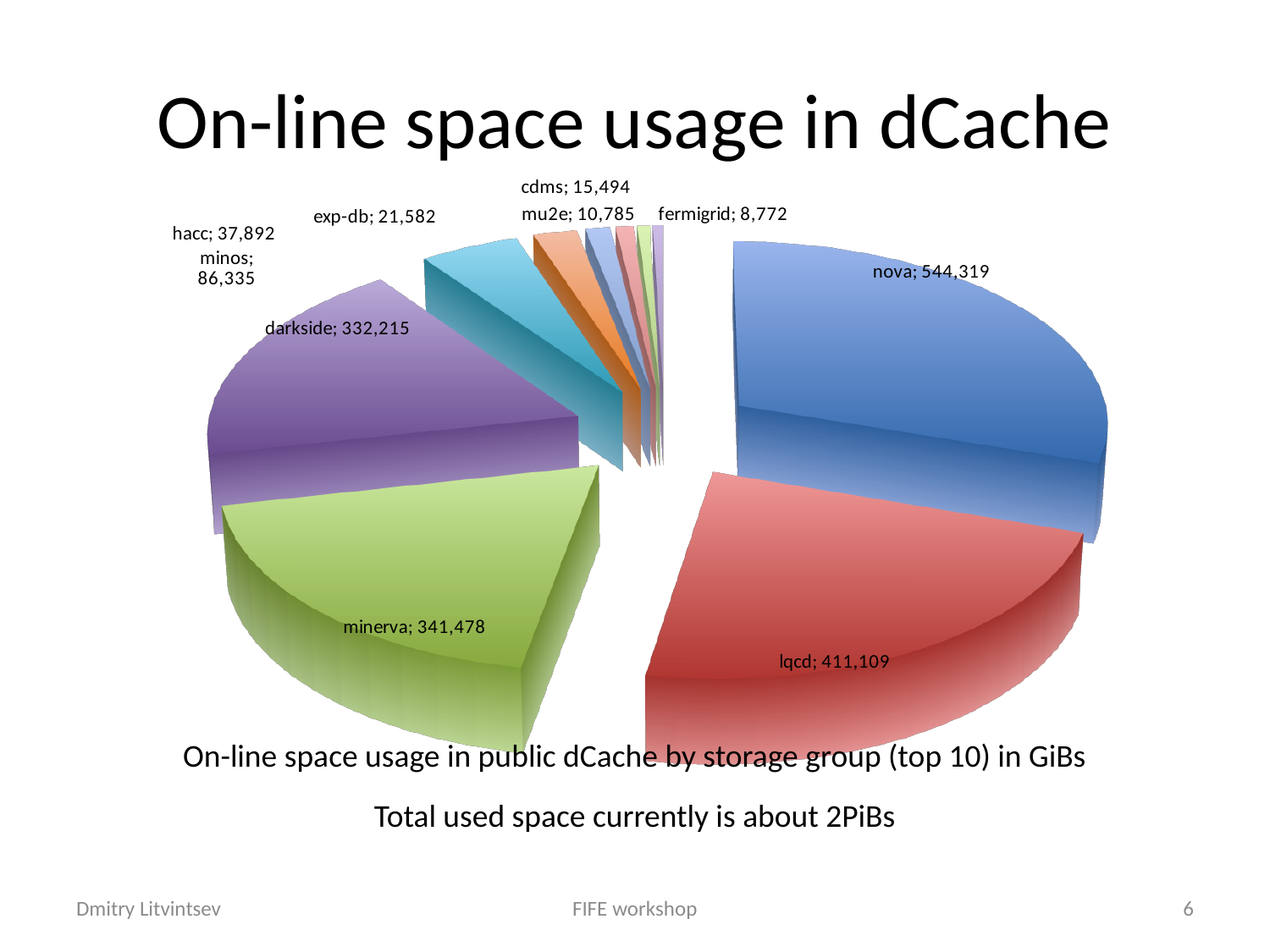
What kind of chart is shown on the slide? pie chart What is the value shown for nova? 544,319 How many storage groups are shown in the pie chart? 10 What is the difference between the values for minos and hacc? 48,443 What is the value shown for fermigrid? 8,772 Which storage group has the smallest slice of the pie? fermigrid Which is larger, the value for minerva or the value for darkside? minerva Which storage group has the largest slice of the pie? nova What is the value shown for darkside? 332,215 What is the difference between the values for nova and lqcd? 133,210 In what unit are the values in the chart given, according to the caption? GiBs What is the value shown for lqcd? 411,109